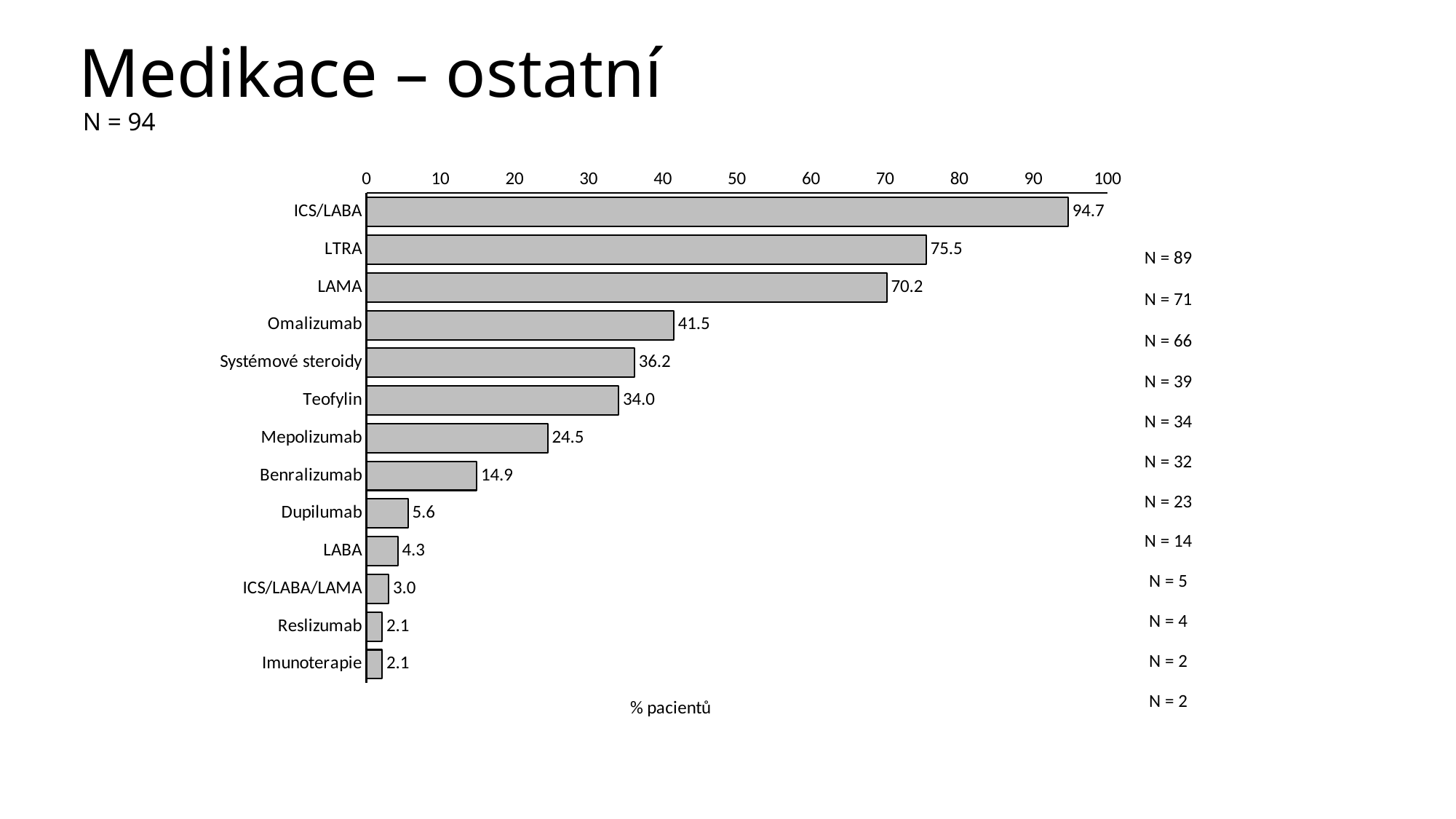
What is the value for Benralizumab? 14.9 What kind of chart is shown on the slide? bar chart What is the value for Systémové steroidy? 36.2 How many categories are shown in the chart? 13 What is the difference between the values for LTRA and LAMA? 5.3 What is the difference between the values for Mepolizumab and Benralizumab? 9.6 What is the label on the horizontal axis of the chart? % pacientů Is the value for LAMA greater or less than 60? greater Which category has the highest value? ICS/LABA Which is larger, the value for Teofylin or the value for Mepolizumab? Teofylin What is the value for ICS/LABA? 94.7 What is the value for Omalizumab? 41.5